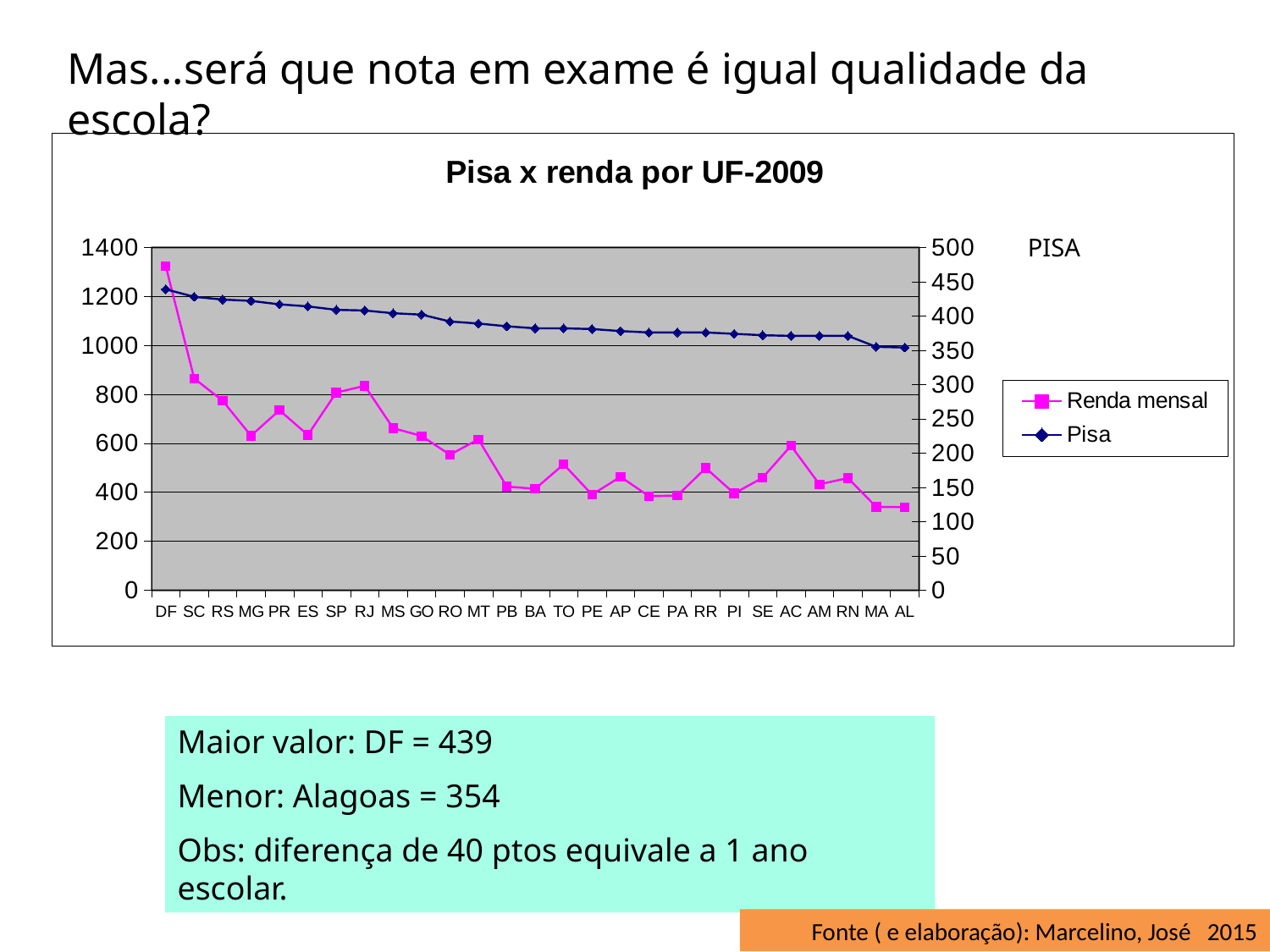
Which UF has the highest Renda mensal value? DF What type of chart is shown on the slide? line chart Is the Renda mensal value for AL greater or less than 400? less How many UF categories are plotted along the x axis? 27 What is the Pisa value for AL (Alagoas)? 354 What is the Pisa value for DF? 439 What is the title of the chart? Pisa x renda por UF-2009 Does the Pisa series rise or fall moving from DF to AL along the x axis? fall Which UF has the lowest Pisa value? AL Is the Renda mensal value for DF greater or less than 1200? greater What is the difference between the Pisa value for DF and the Pisa value for AL? 85 How many series does the chart legend list? 2